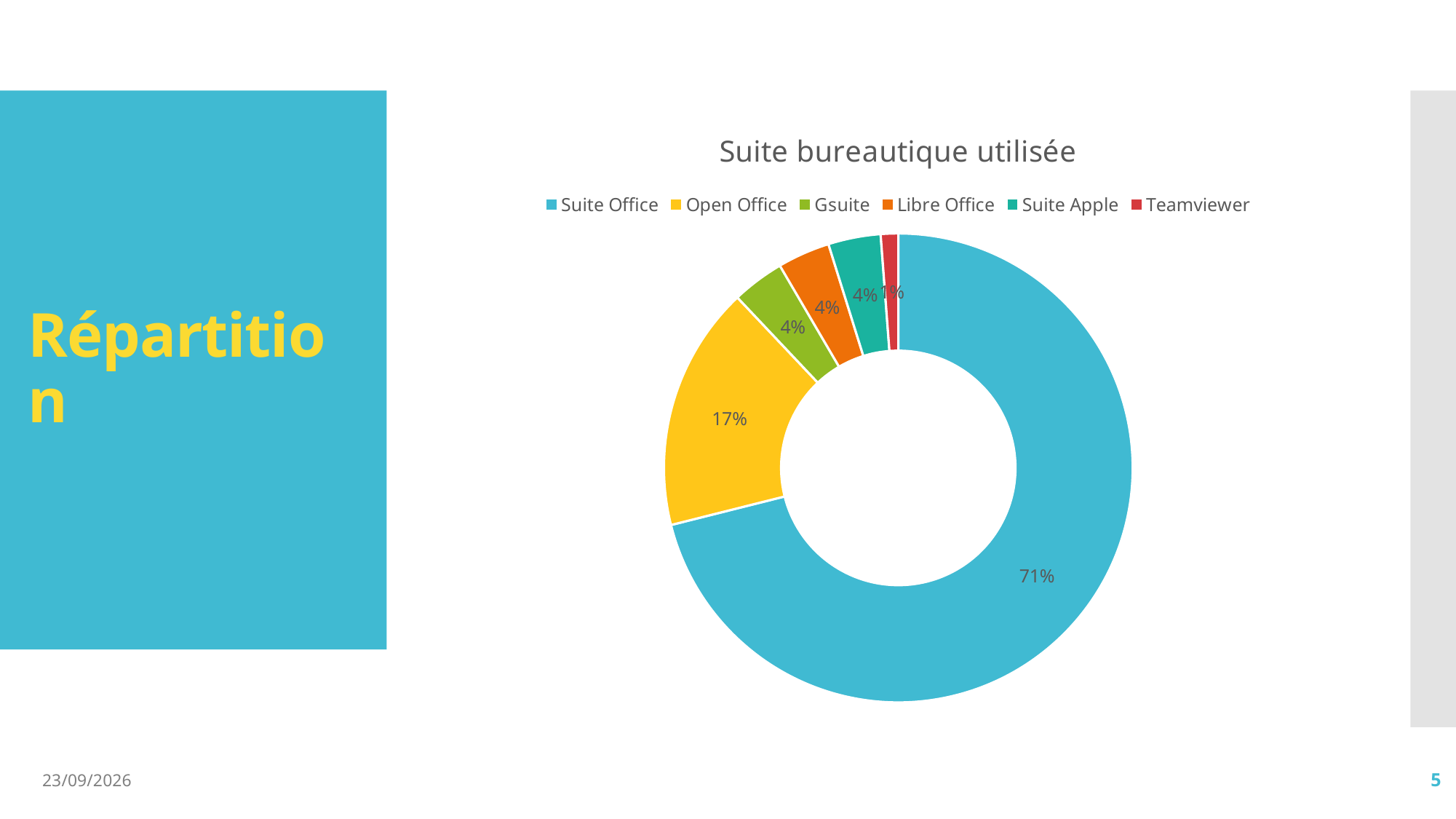
Which category has the smallest share? Teamviewer Which category has the largest share? Suite Office How many categories does the legend list? 6 What is the title of the chart? Suite bureautique utilisée What share of the chart does Suite Office represent? 71% Which has a larger share, Open Office or Libre Office? Open Office What is the difference in percentage points between Suite Office and Open Office? 54 What share of the chart does Gsuite represent? 4% What share of the chart does Teamviewer represent? 1% What kind of chart is shown on the slide? Doughnut chart What share of the chart does Open Office represent? 17% What colour is the Suite Apple slice? Teal